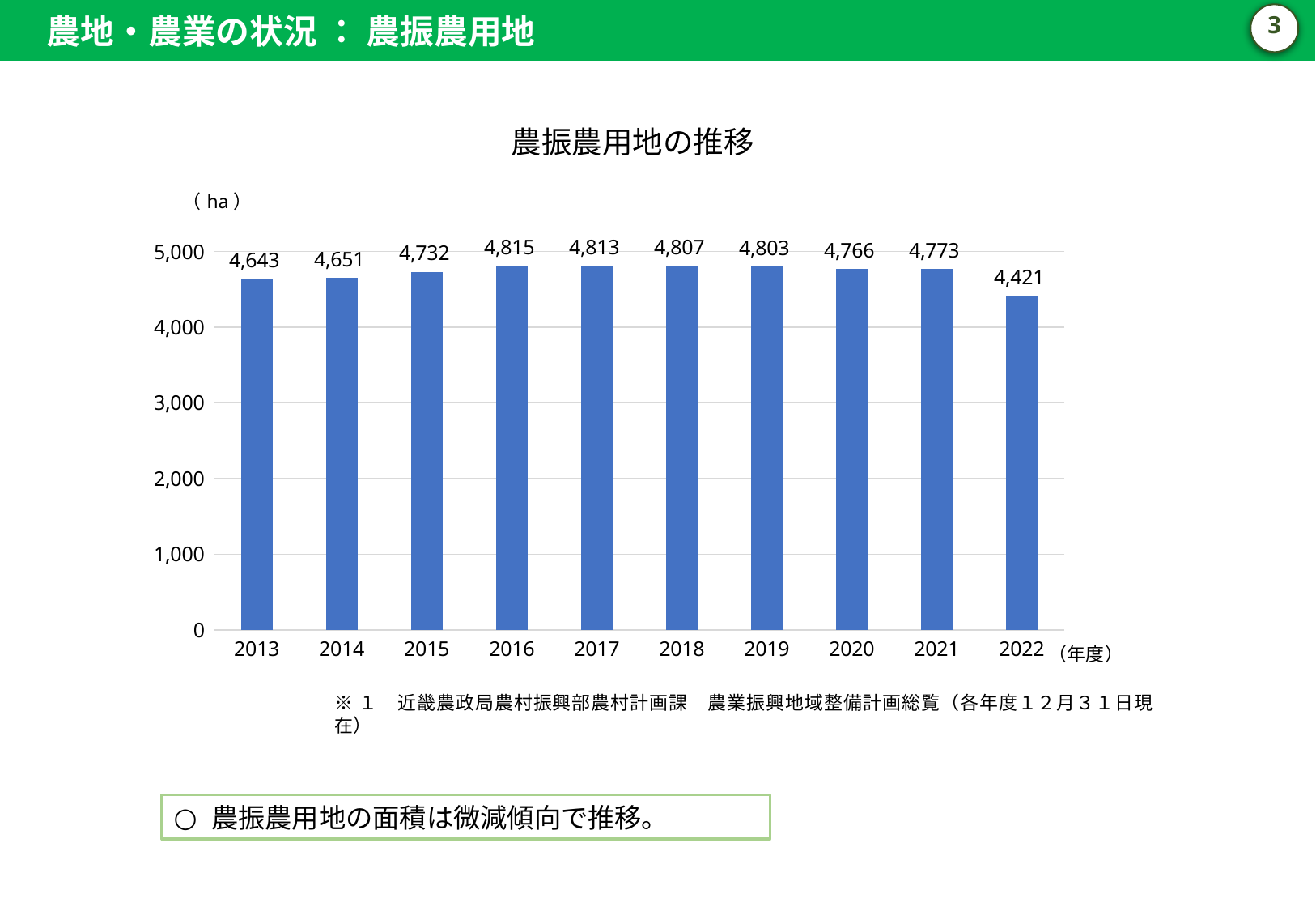
What is the difference between the values for 2021 and 2022? 352 Which is larger, the value for 2015 or the value for 2020? 2020 Which year has the lowest value? 2022 What is the value for 2022? 4,421 What is the difference between the values for 2016 and 2013? 172 What kind of chart is shown on the slide? bar chart How many years are shown on the x axis? 10 Which year has the highest value? 2016 What is the value for 2018? 4,807 What is the title of the chart? 農振農用地の推移 Is the value for 2022 greater or less than 4,000? greater What is the value for 2013? 4,643